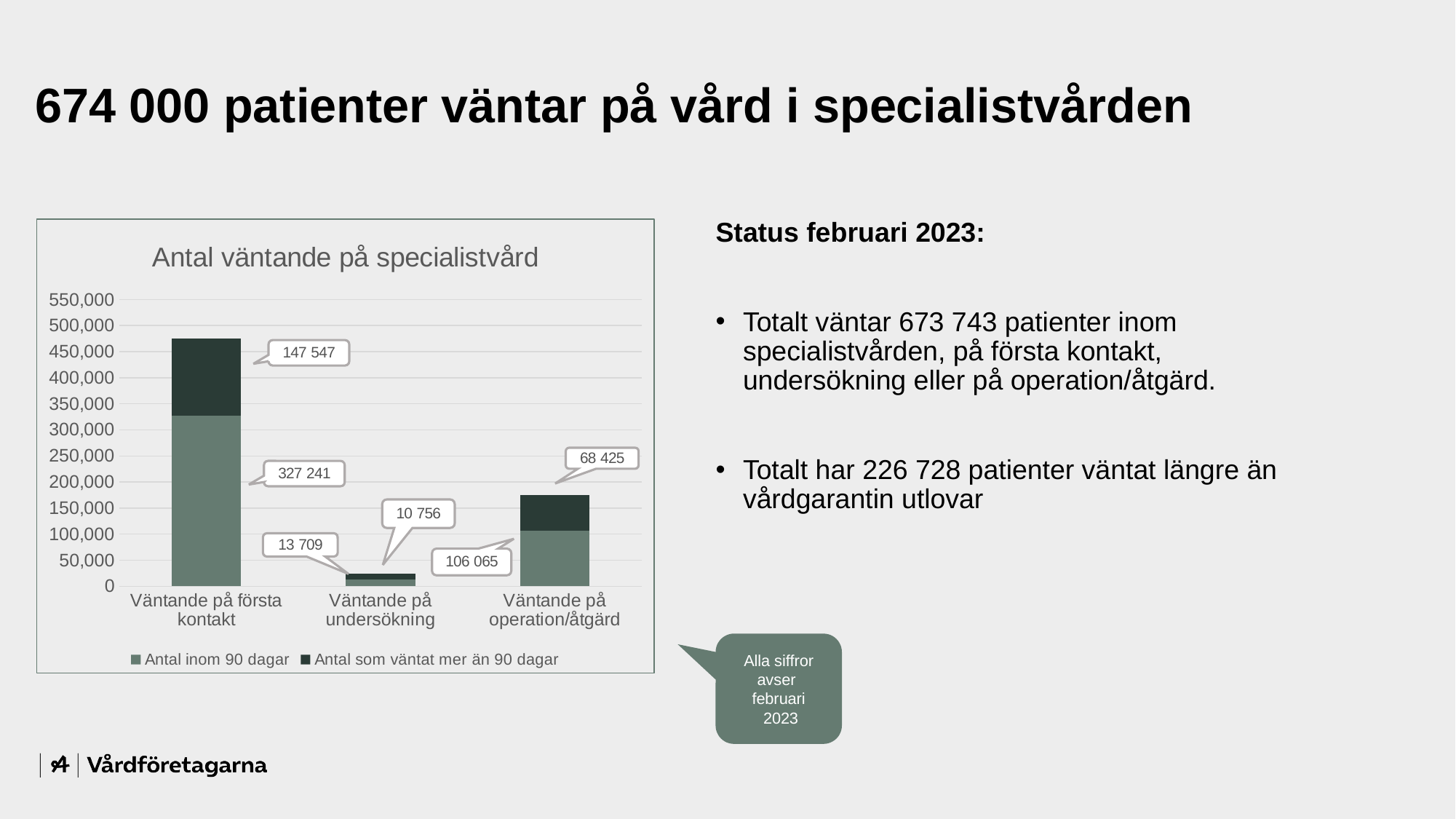
Which category has the lowest total number of waiting patients? Väntande på undersökning What is the total of the stacked bar for 'Väntande på operation/åtgärd'? 174 490 Which category has the highest total number of waiting patients? Väntande på första kontakt Is the total for 'Väntande på första kontakt' greater or less than 450,000? greater What is the title of the chart? Antal väntande på specialistvård What is the difference between 'Antal inom 90 dagar' and 'Antal som väntat mer än 90 dagar' for 'Väntande på första kontakt'? 179 694 What is the value of 'Antal som väntat mer än 90 dagar' for 'Väntande på undersökning'? 10 756 How many series does the chart legend list? 2 What is the value of 'Antal inom 90 dagar' for 'Väntande på första kontakt'? 327 241 What is the value of 'Antal som väntat mer än 90 dagar' for 'Väntande på operation/åtgärd'? 68 425 How many categories are shown on the x axis of the chart? 3 What type of chart is shown on the slide? Stacked bar chart